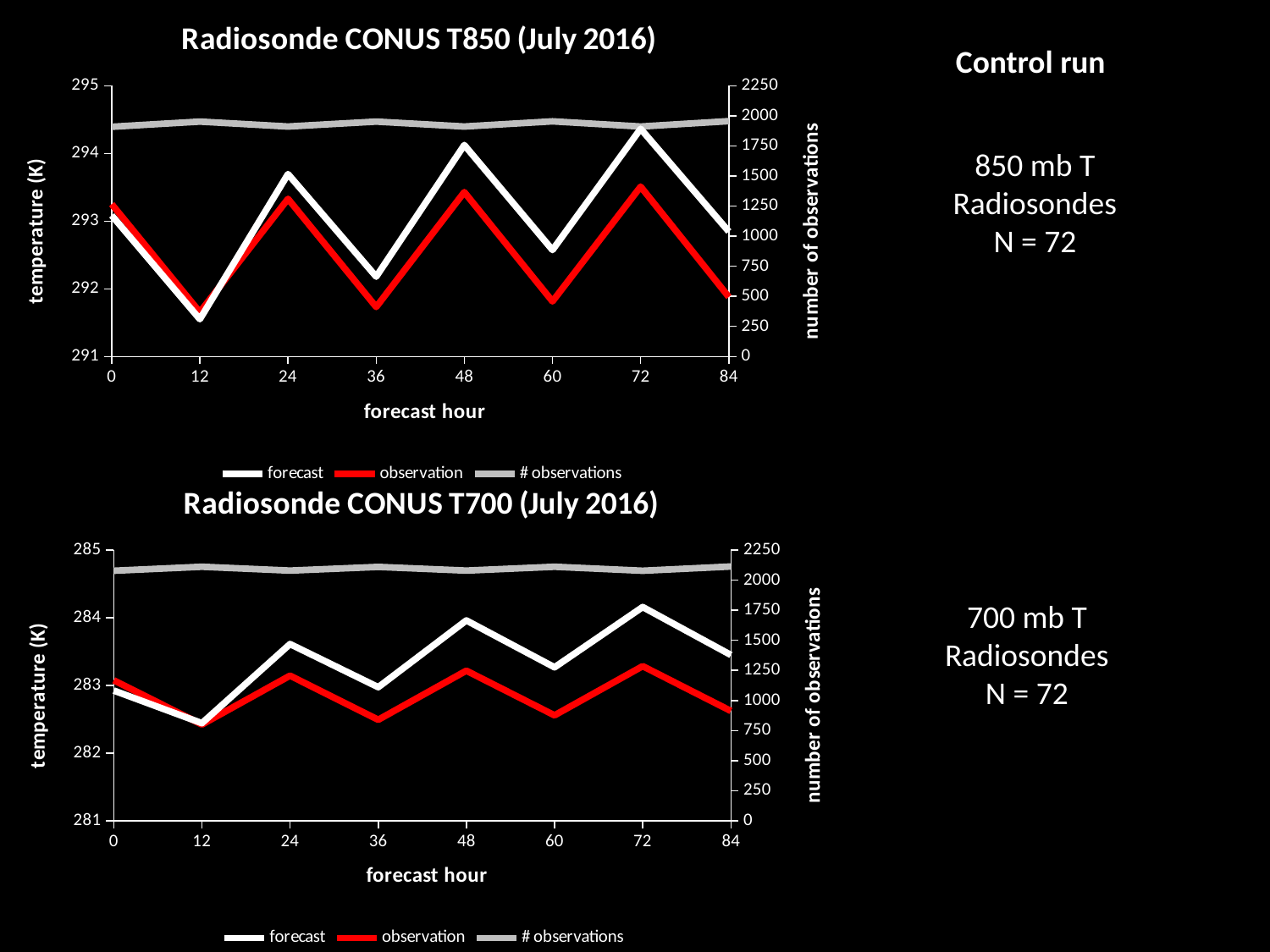
In the 'Radiosonde CONUS T700 (July 2016)' chart, is the number of observations at forecast hour 84 greater or less than 2000? greater In the 'Radiosonde CONUS T850 (July 2016)' chart, is the forecast temperature at forecast hour 12 greater or less than 292? less How many forecast hours are plotted along the x axis of the 'Radiosonde CONUS T850 (July 2016)' chart? 8 In the 'Radiosonde CONUS T850 (July 2016)' chart, at which forecast hour is the forecast temperature highest? 72 What kind of chart is the 'Radiosonde CONUS T850 (July 2016)' chart? line chart In the 'Radiosonde CONUS T700 (July 2016)' chart, at which forecast hour is the forecast temperature highest? 72 How many series does the legend of the 'Radiosonde CONUS T700 (July 2016)' chart list? 3 In the 'Radiosonde CONUS T850 (July 2016)' chart, at forecast hour 48, which is higher: the forecast or the observation? forecast What is the label of the left y axis on the 'Radiosonde CONUS T700 (July 2016)' chart? temperature (K) In the 'Radiosonde CONUS T850 (July 2016)' chart, is the number of observations at forecast hour 0 greater or less than 1750? greater In the 'Radiosonde CONUS T850 (July 2016)' chart, at which forecast hour is the forecast temperature lowest? 12